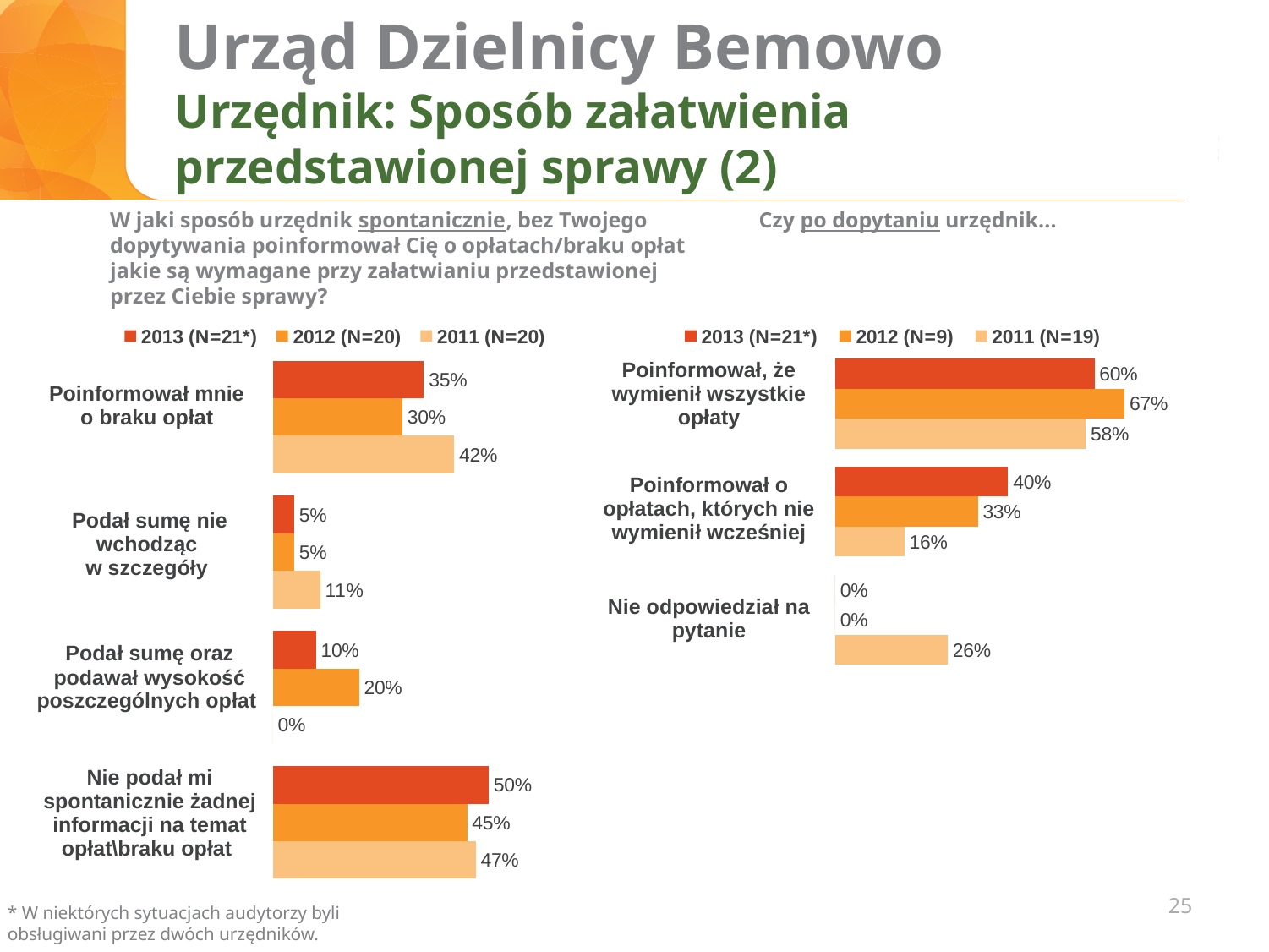
In the left chart, how many series does the legend list? 3 In the left chart, how many categories are shown? 4 In the right chart, is the 2013 value for "Poinformował o opłatach, których nie wymienił wcześniej" larger or smaller than the 2012 value? larger In the left chart, what is the 2011 value for "Podał sumę nie wchodząc w szczegóły"? 11% In the left chart, which category has the highest 2013 value? Nie podał mi spontanicznie żadnej informacji na temat opłat\braku opłat In the left chart, what is the 2013 value for "Poinformował mnie o braku opłat"? 35% What type of chart is the right chart? bar chart In the left chart, what is the difference between the 2012 and 2013 values for "Podał sumę oraz podawał wysokość poszczególnych opłat"? 10 percentage points In the right chart, what is the 2011 value for "Nie odpowiedział na pytanie"? 26% In the right chart, what is the 2012 value for "Poinformował, że wymienił wszystkie opłaty"? 67% In the right chart, what sample size is given for 2012 in the legend? N=9 In the right chart, which year has the lowest value for "Poinformował o opłatach, których nie wymienił wcześniej"? 2011 (N=19)